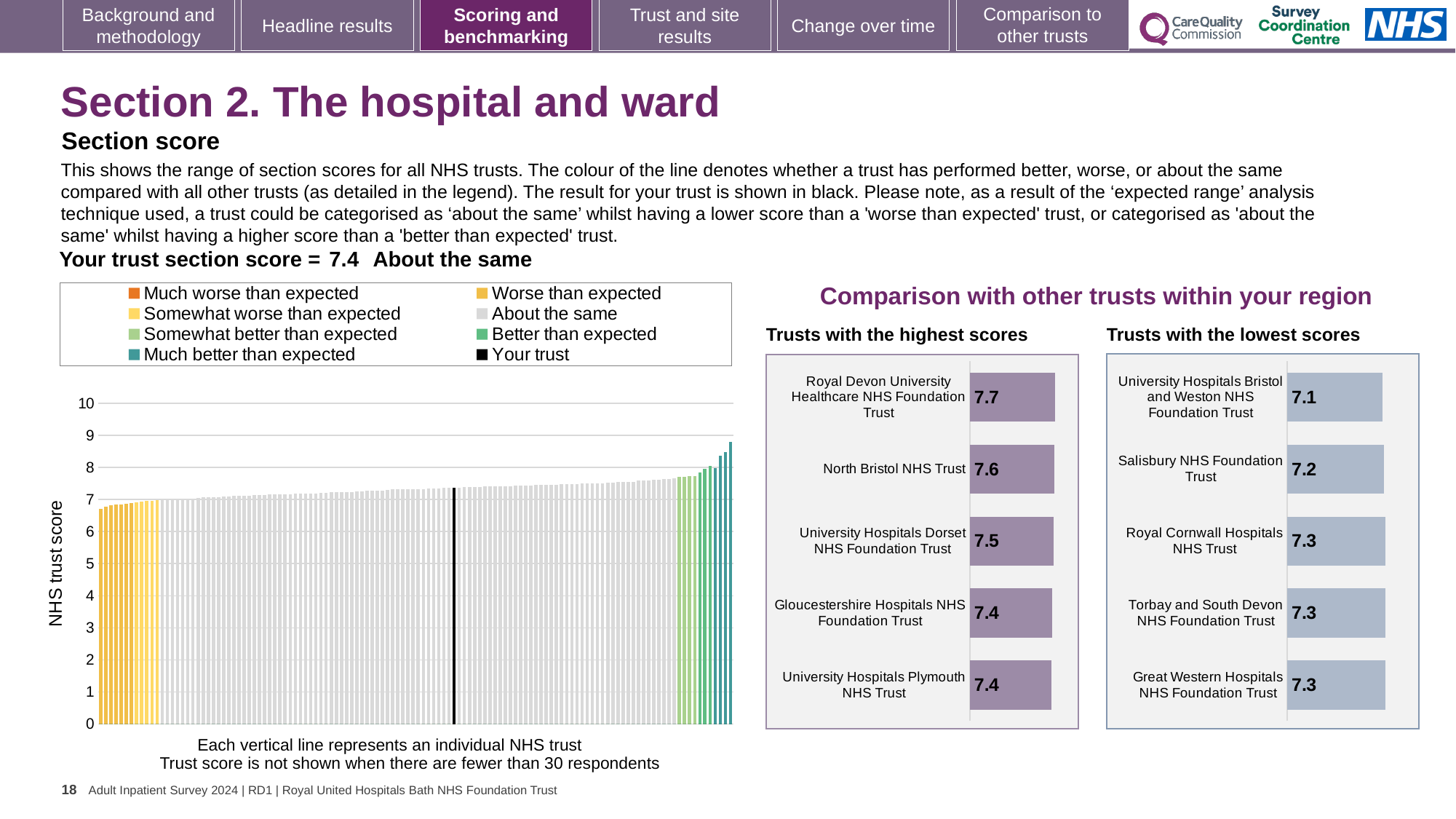
In the 'Trusts with the lowest scores' chart, which trust has the lowest score? University Hospitals Bristol and Weston NHS Foundation Trust In the large chart on the left, is the value of the tallest bar greater or less than 8? greater What kind of chart is the large chart on the left showing NHS trust scores? Bar chart In the 'Trusts with the highest scores' chart, what is the difference between the scores of Royal Devon University Healthcare NHS Foundation Trust and University Hospitals Plymouth NHS Trust? 0.3 How many trusts are listed in the 'Trusts with the highest scores' chart? 5 In the large chart on the left, do the trust scores rise or fall from left to right? Rise In the 'Trusts with the lowest scores' chart, how many trusts have a score of 7.3? 3 In the 'Trusts with the lowest scores' chart, what is the score for Salisbury NHS Foundation Trust? 7.2 In the 'Trusts with the lowest scores' chart, which has the larger score: University Hospitals Bristol and Weston NHS Foundation Trust or Royal Cornwall Hospitals NHS Trust? Royal Cornwall Hospitals NHS Trust How many entries does the legend of the large chart on the left list? 8 In the 'Trusts with the highest scores' chart, which trust has the highest score? Royal Devon University Healthcare NHS Foundation Trust In the 'Trusts with the highest scores' chart, what is the score for Royal Devon University Healthcare NHS Foundation Trust? 7.7